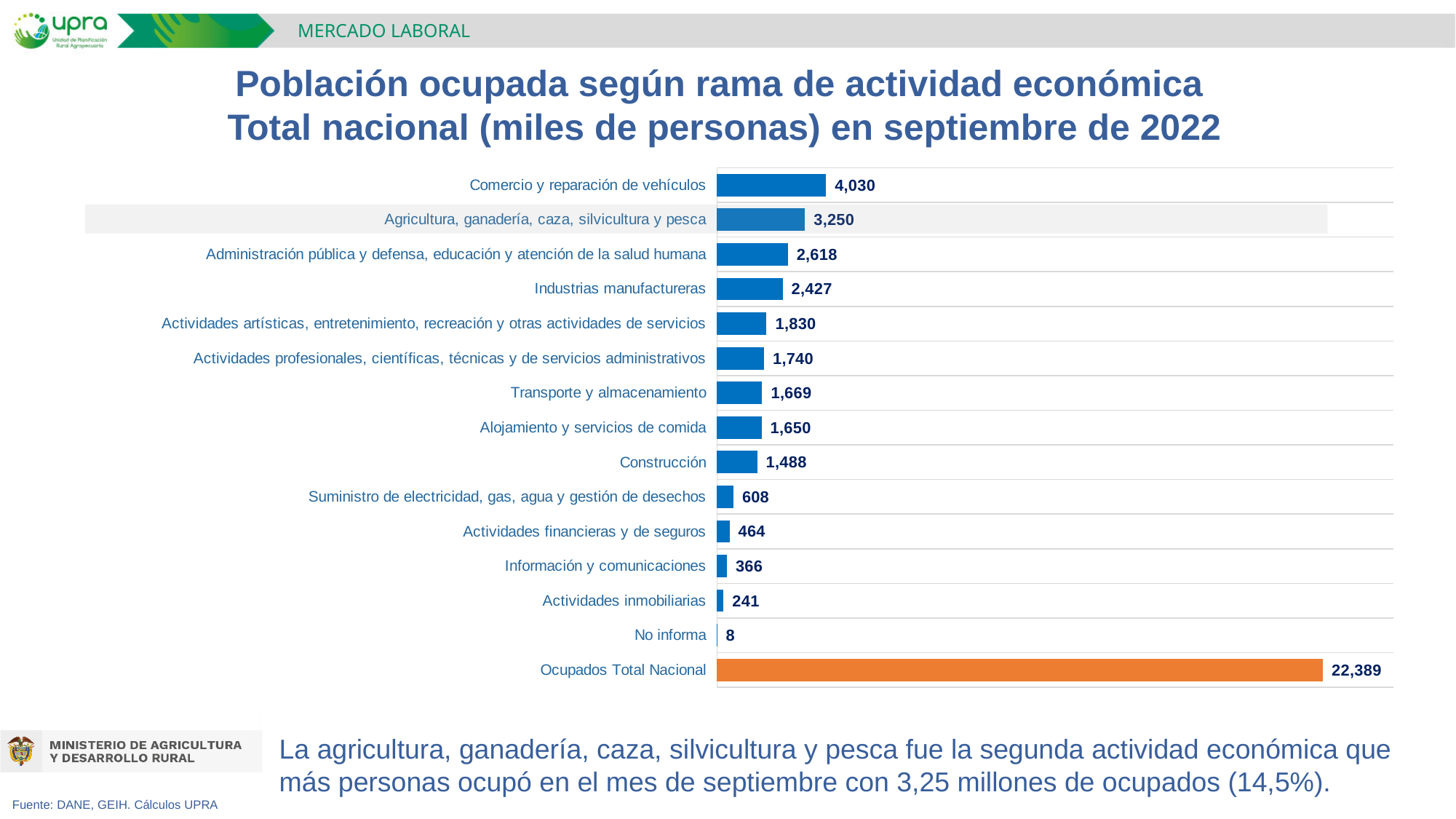
What is the value for Ocupados Total Nacional? 22,389 Which is larger, Industrias manufactureras or Transporte y almacenamiento? Industrias manufactureras What is the value for Agricultura, ganadería, caza, silvicultura y pesca? 3,250 What is the value for Comercio y reparación de vehículos? 4,030 Which category has the lowest value? No informa How many categories are shown in the chart? 15 Excluding the Ocupados Total Nacional bar, which category has the highest value? Comercio y reparación de vehículos What kind of chart is shown on the slide? Bar chart What is the value for Construcción? 1,488 What is the difference between Suministro de electricidad, gas, agua y gestión de desechos and Actividades financieras y de seguros? 144 Which bar is shown in orange rather than blue? Ocupados Total Nacional What is the difference between Comercio y reparación de vehículos and Agricultura, ganadería, caza, silvicultura y pesca? 780